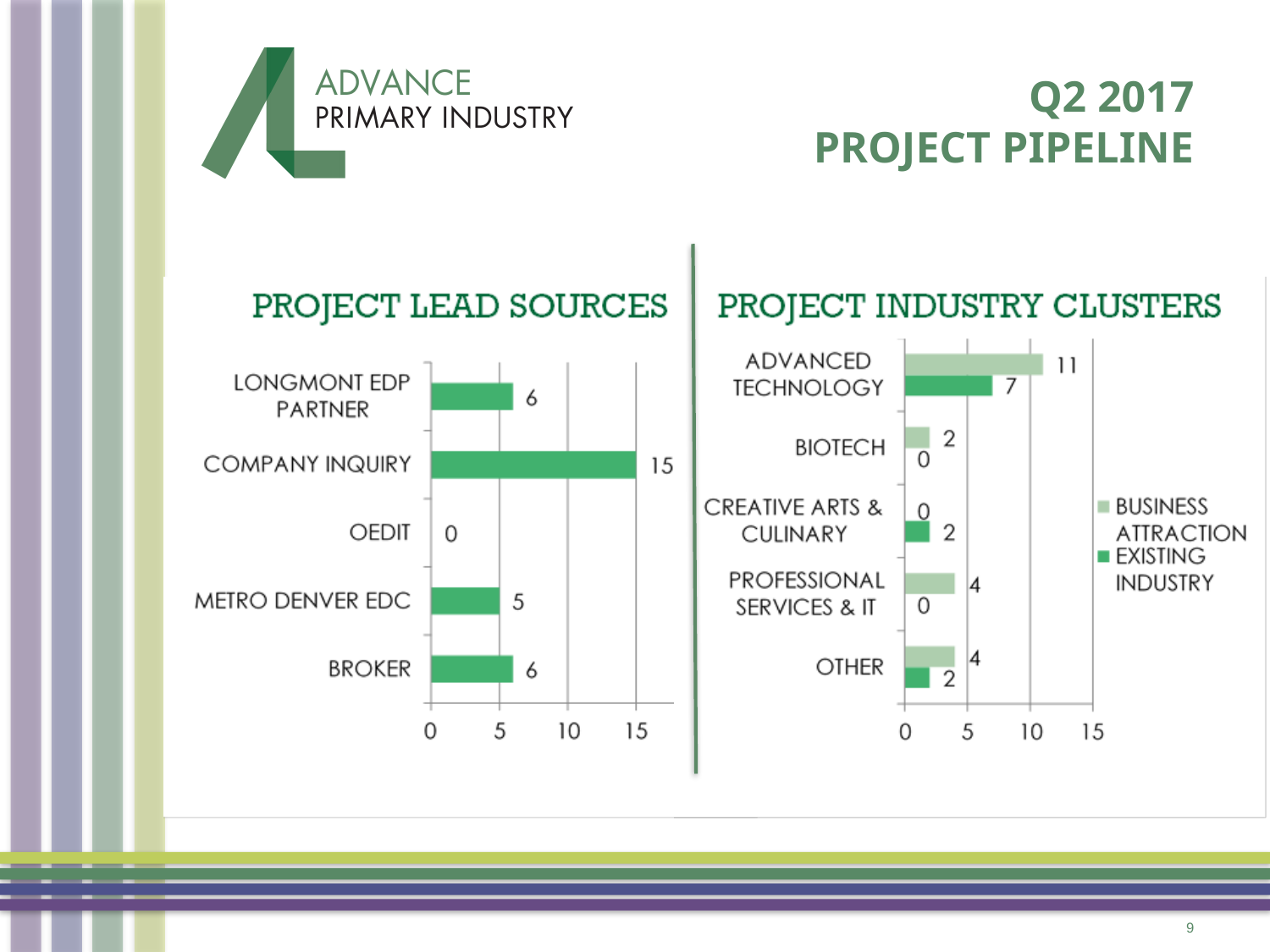
In the Project Industry Clusters chart, what is the difference between the Business Attraction and Existing Industry values for Professional Services & IT? 4 In the Project Industry Clusters chart, what is the Existing Industry value for Other? 2 In the Project Lead Sources chart, how many lead source categories are shown? 5 In the Project Industry Clusters chart, how many series does the legend list? 2 In the Project Lead Sources chart, which lead source has the highest value? Company Inquiry In the Project Lead Sources chart, what is the value for Company Inquiry? 15 What kind of chart is the Project Lead Sources chart? Bar chart In the Project Industry Clusters chart, which industry cluster has the highest Existing Industry value? Advanced Technology In the Project Lead Sources chart, which lead source has the lowest value? OEDIT In the Project Industry Clusters chart, what is the Business Attraction value for Advanced Technology? 11 In the Project Lead Sources chart, what is the difference between Company Inquiry and Metro Denver EDC? 10 In the Project Industry Clusters chart, which is larger for Advanced Technology: Business Attraction or Existing Industry? Business Attraction